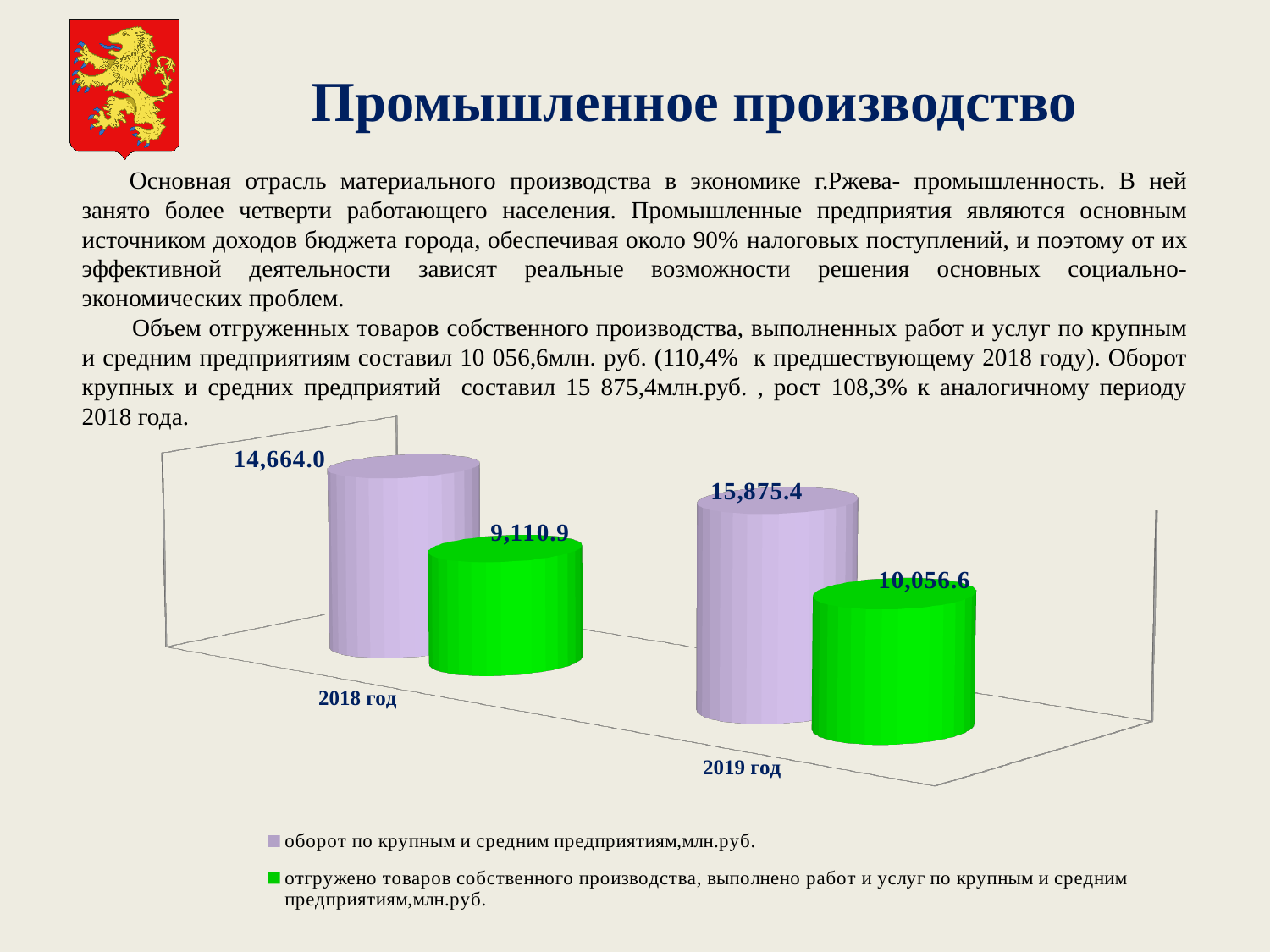
What is the value of оборот по крупным и средним предприятиям for 2018 год? 14,664.0 How many series does the legend list? 2 What is the value of отгружено товаров собственного производства, выполнено работ и услуг for 2019 год? 10,056.6 What is the difference between оборот and отгружено товаров in 2019 год? 5,818.8 How many years (categories) are shown on the chart? 2 By how much did оборот по крупным и средним предприятиям increase from 2018 год to 2019 год? 1,211.4 What is the value of отгружено товаров собственного производства, выполнено работ и услуг for 2018 год? 9,110.9 What is the value of оборот по крупным и средним предприятиям for 2019 год? 15,875.4 Which is larger in 2018 год: оборот по крупным и средним предприятиям or отгружено товаров собственного производства? оборот по крупным и средним предприятиям Which year has the higher value for оборот по крупным и средним предприятиям? 2019 год Which year has the lower value for отгружено товаров собственного производства, выполнено работ и услуг? 2018 год What kind of chart is shown on the slide? bar chart